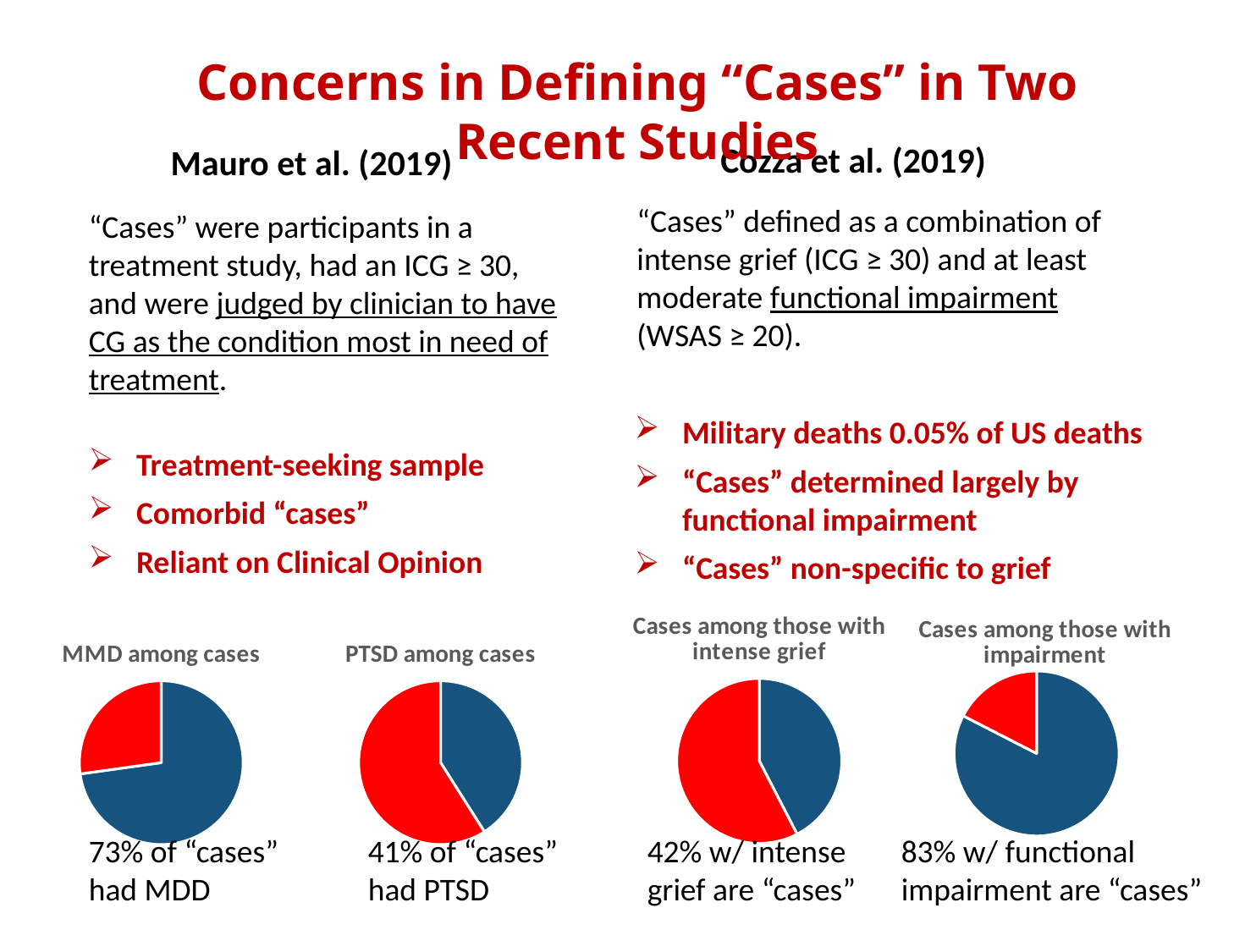
What kind of chart is used for "MMD among cases"? pie chart How many slices does the "PTSD among cases" pie chart have? 2 According to the caption under the "Cases among those with intense grief" pie chart, what percentage of those with intense grief are "cases"? 42% According to the caption under the "Cases among those with impairment" pie chart, what percentage of those with functional impairment are "cases"? 83% Which pie chart has the larger blue slice: "Cases among those with intense grief" or "Cases among those with impairment"? Cases among those with impairment What is the title of the pie chart at the far right of the slide? Cases among those with impairment How many pie charts are shown on the slide? 4 In the "Cases among those with impairment" pie chart, is the red slice greater or less than 50% of the pie? less In the "MMD among cases" pie chart, is the blue slice greater or less than 50% of the pie? greater According to the caption under the "PTSD among cases" pie chart, what percentage of "cases" had PTSD? 41% Which of the two pie charts under Mauro et al. (2019) has the larger red slice? PTSD among cases